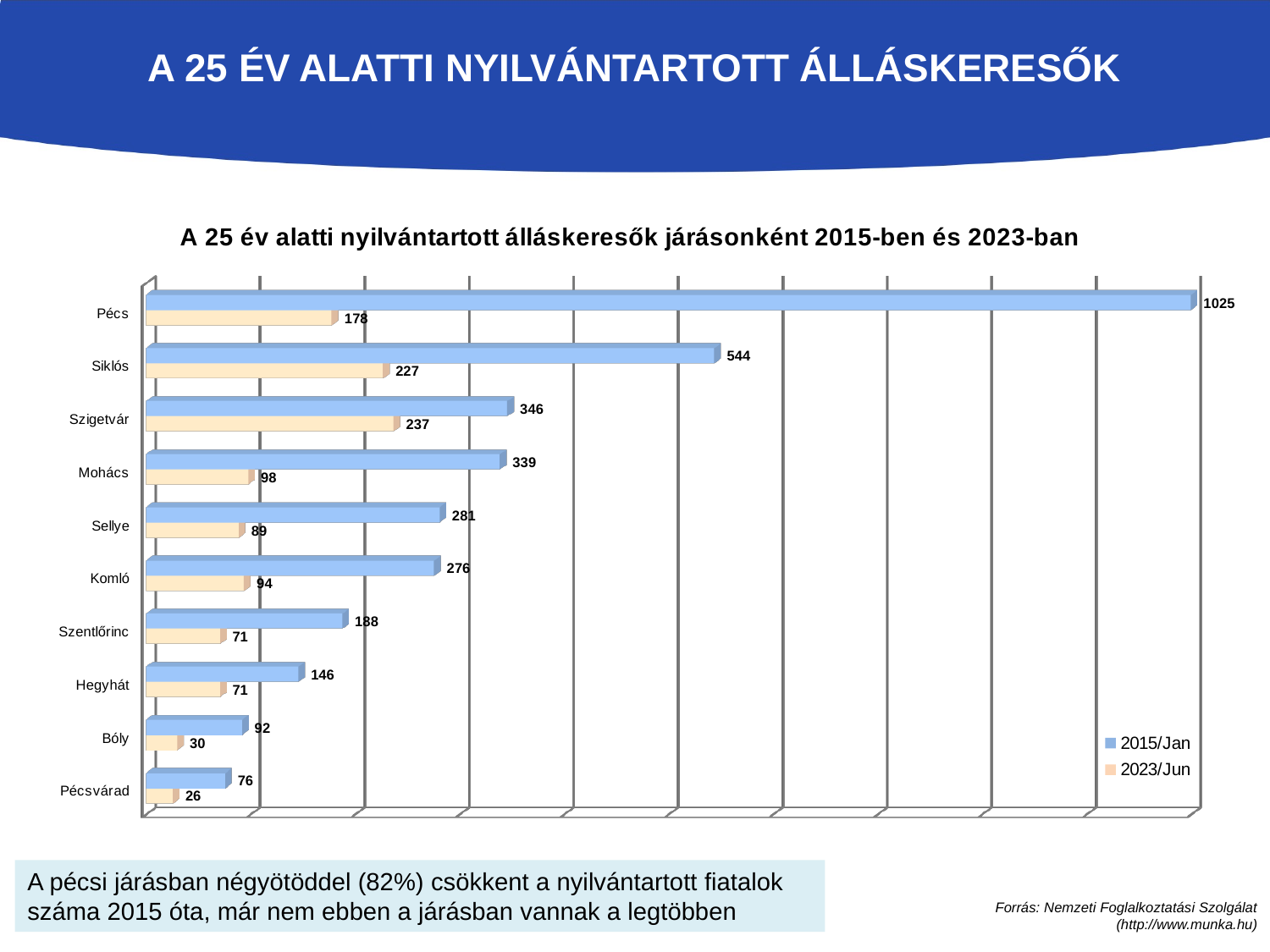
What is the title of the chart? A 25 év alatti nyilvántartott álláskeresők járásonként 2015-ben és 2023-ban Which is larger: the 2023/Jun value for Mohács or the 2023/Jun value for Komló? Mohács What is the 2023/Jun value for Szigetvár? 237 What kind of chart is shown on the slide? Bar chart Which district has the lowest 2015/Jan value? Pécsvárad Which district has the highest 2023/Jun value? Szigetvár What is the 2015/Jan value for Pécs? 1025 What is the difference between the 2015/Jan and 2023/Jun values for Siklós? 317 How many districts are shown on the chart? 10 How many series does the legend list? 2 What is the 2023/Jun value for Bóly? 30 What is the difference between the 2015/Jan values for Pécs and Siklós? 481